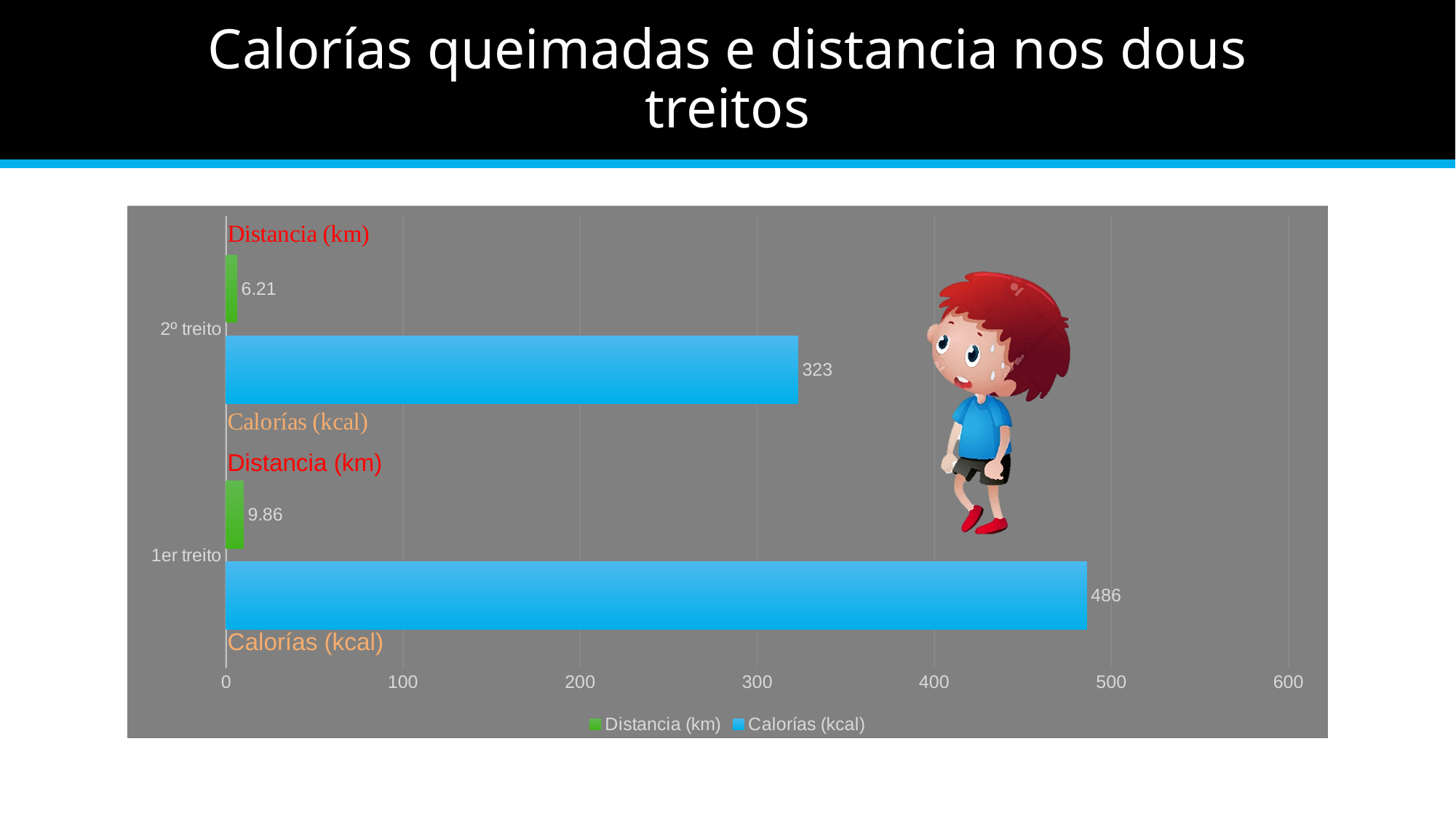
What is the Distancia (km) value for 1er treito? 9.86 Which treito has the higher Calorías (kcal) value? 1er treito How many series does the legend list? 2 What is the difference in Distancia (km) between 1er treito and 2º treito? 3.65 What is the Distancia (km) value for 2º treito? 6.21 What is the Calorías (kcal) value for 2º treito? 323 Is the Calorías (kcal) value for 2º treito greater or less than 400? less What kind of chart is shown on the slide? bar chart What is the Calorías (kcal) value for 1er treito? 486 What is the difference in Calorías (kcal) between 1er treito and 2º treito? 163 How many categories (treitos) are shown on the chart? 2 Which treito has the lower Distancia (km) value? 2º treito